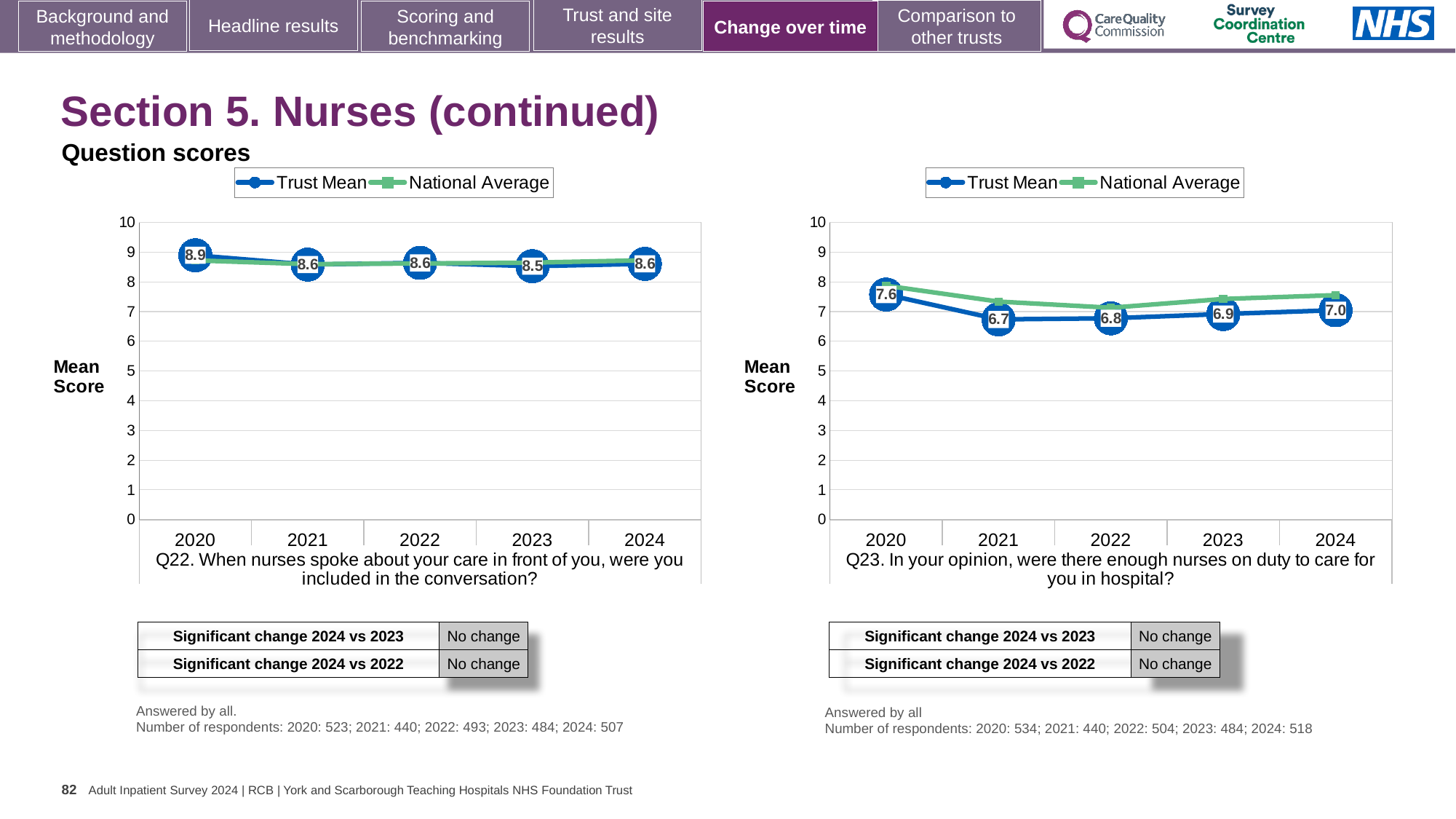
How many series does the legend of the Q23 chart (right) list? 2 In the Q22 chart (left), which year has the highest Trust Mean score? 2020 In the Q23 chart (right), what is the Trust Mean score for 2021? 6.7 In the Q22 chart (left), is the Trust Mean score for 2020 larger or smaller than the score for 2023? larger In the Q22 chart (left), what is the Trust Mean score for 2020? 8.9 In the Q23 chart (right), what is the difference between the Trust Mean scores for 2020 and 2021? 0.9 What kind of chart is used for Q22 (left)? line chart In the Q23 chart (right), is the National Average for 2021 greater or less than 8? less In the Q23 chart (right), which year has the lowest Trust Mean score? 2021 How many years are plotted on the x axis of the Q22 chart (left)? 5 In the Q23 chart (right), what is the Trust Mean score for 2024? 7.0 In the Q22 chart (left), what is the Trust Mean score for 2023? 8.5